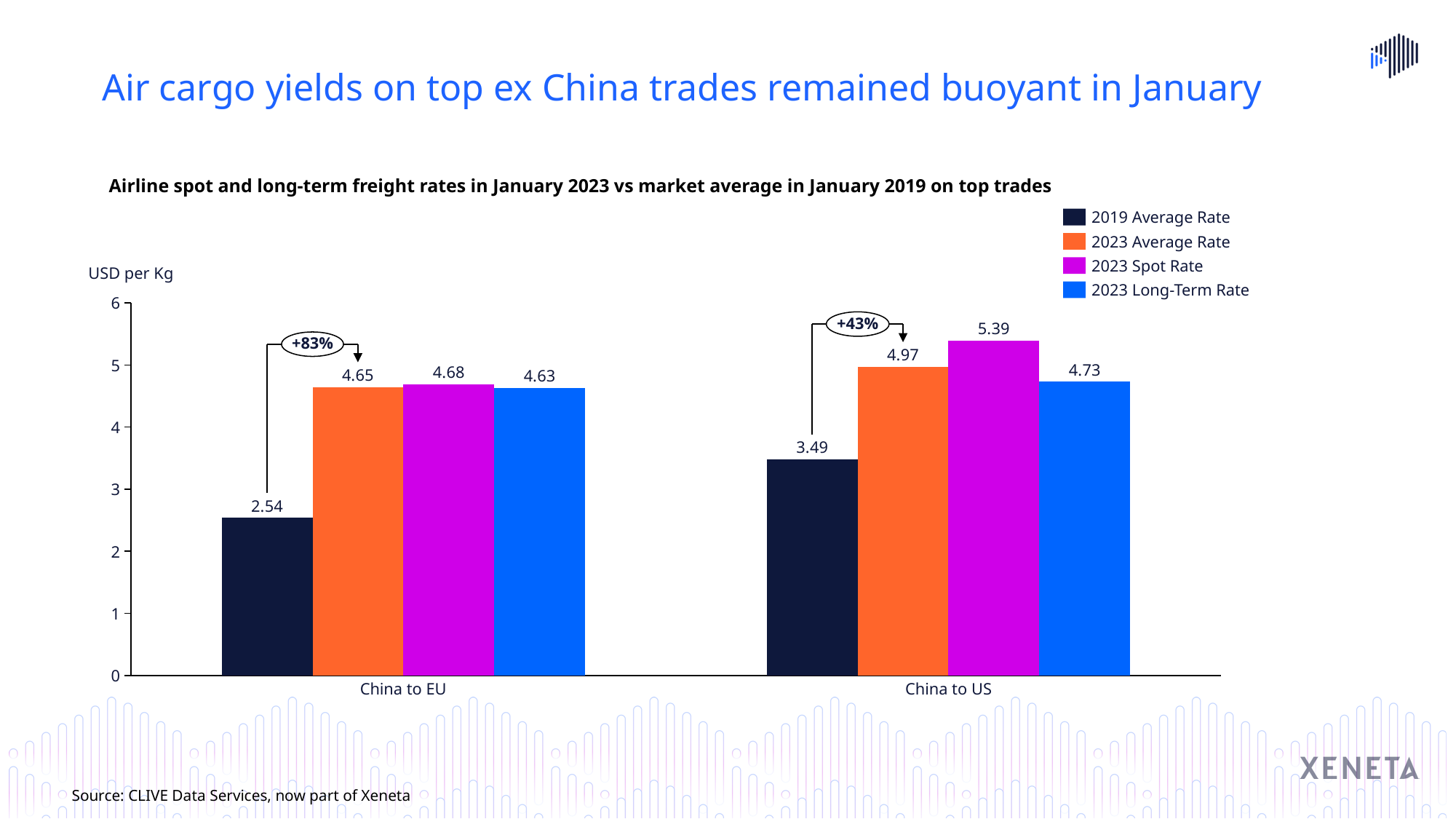
How many series does the legend list? 4 What percentage increase is annotated between the 2019 Average Rate and the 2023 Average Rate for China to EU? +83% What is the 2023 Average Rate for China to US? 4.97 What is the 2019 Average Rate for China to EU? 2.54 What is the difference between the 2023 Average Rate and the 2019 Average Rate for China to US? 1.48 Which series has the highest value for China to US? 2023 Spot Rate What kind of chart is shown on the slide? Bar chart Which series has the lowest value for China to EU? 2019 Average Rate What is the 2023 Long-Term Rate for China to EU? 4.63 How many trade lanes (categories) are shown on the x axis? 2 Which is larger: the 2023 Spot Rate for China to EU or the 2023 Spot Rate for China to US? China to US What is the 2023 Spot Rate for China to US? 5.39